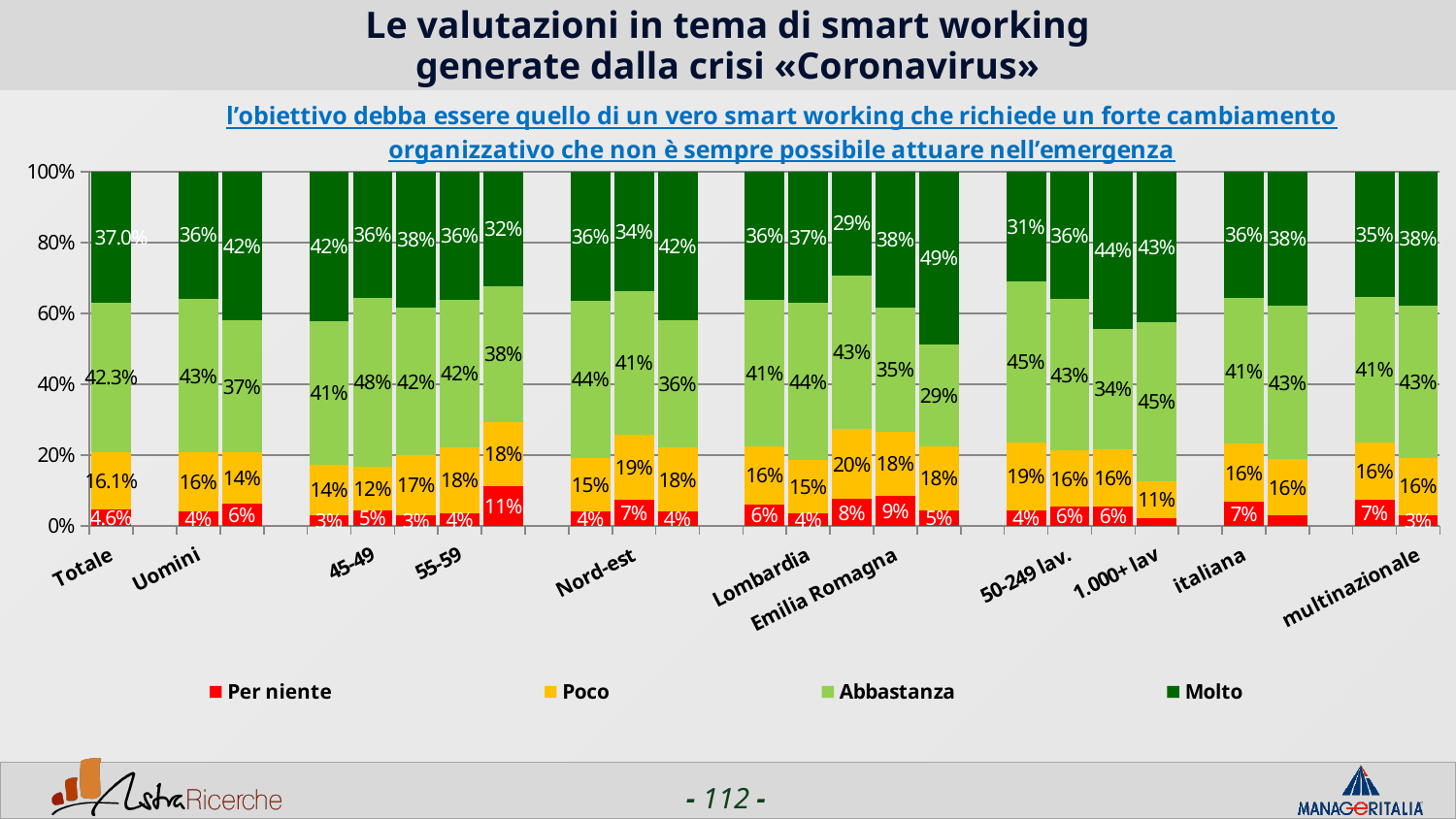
How many series does the legend list? 4 What is the 'Per niente' value for the 'Totale' bar? 4.6% What kind of chart is shown on the slide? Stacked bar chart Which series has the smallest share in the 'Totale' bar? Per niente In the 'Uomini' bar, which is larger: 'Abbastanza' or 'Molto'? Abbastanza What is the 'Abbastanza' value for the 'Uomini' bar? 43% Which legend entry is shown in red? Per niente Which series has the largest share in the 'Totale' bar? Abbastanza What is the 'Molto' value for the 'Totale' bar? 37.0% What is the 'Abbastanza' value for the 'Totale' bar? 42.3% What is the 'Poco' value for the 'Totale' bar? 16.1% In the 'Totale' bar, what is the difference between the 'Abbastanza' and 'Molto' values? 5.3%